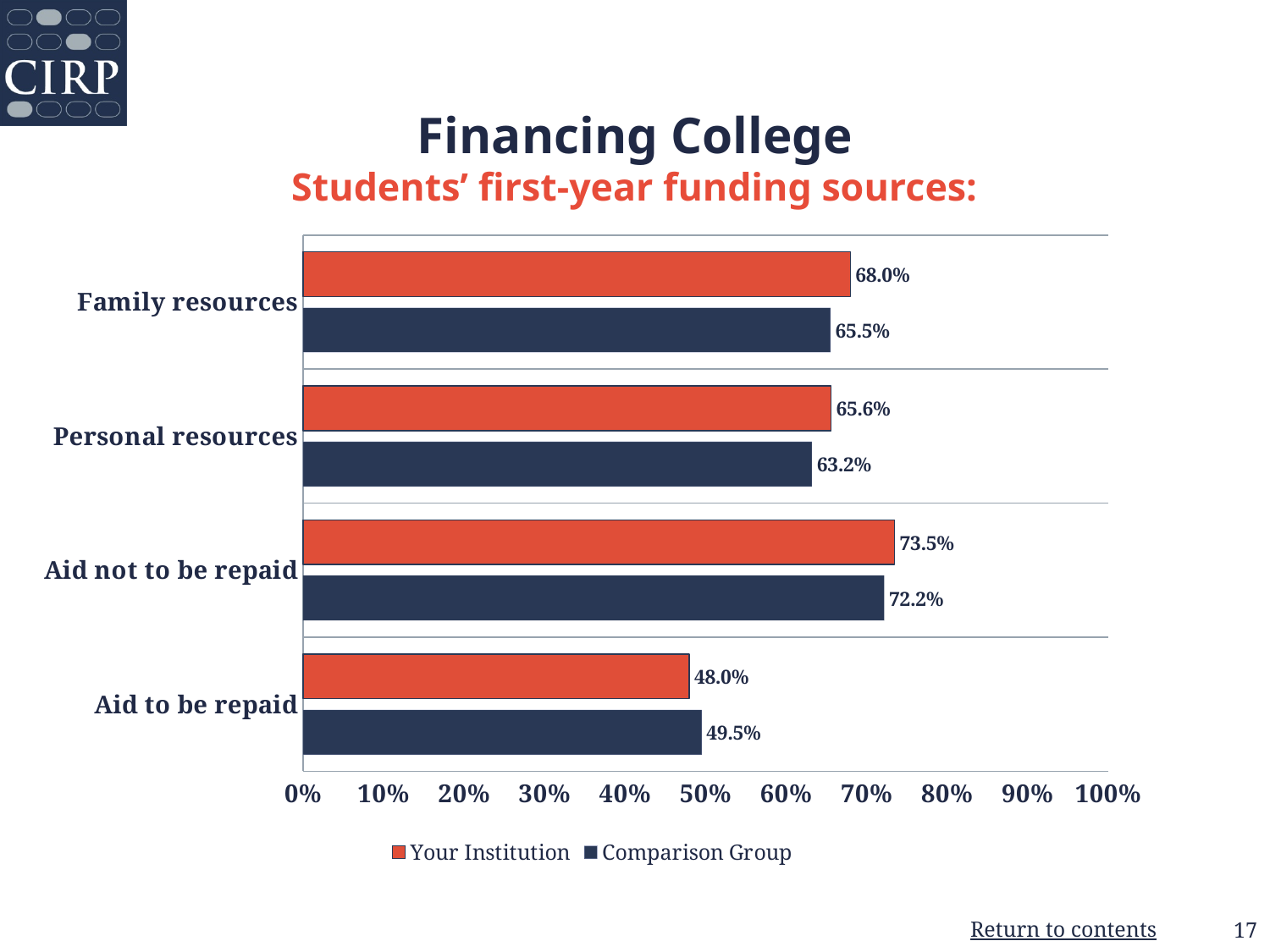
What is the difference between Your Institution and Comparison Group for Aid to be repaid? 1.5% How many series does the legend list? 2 What is the value for Your Institution for Family resources? 68.0% Which category has the highest value for Your Institution? Aid not to be repaid What kind of chart is shown on the slide? Bar chart What is the difference between Your Institution and Comparison Group for Family resources? 2.5% Is the value for Your Institution for Aid not to be repaid greater or less than 70%? greater Which is larger for Aid to be repaid: Your Institution or Comparison Group? Comparison Group Which category has the lowest value for Comparison Group? Aid to be repaid How many categories are shown on the chart? 4 What is the value for Comparison Group for Personal resources? 63.2% What is the value for Comparison Group for Aid to be repaid? 49.5%